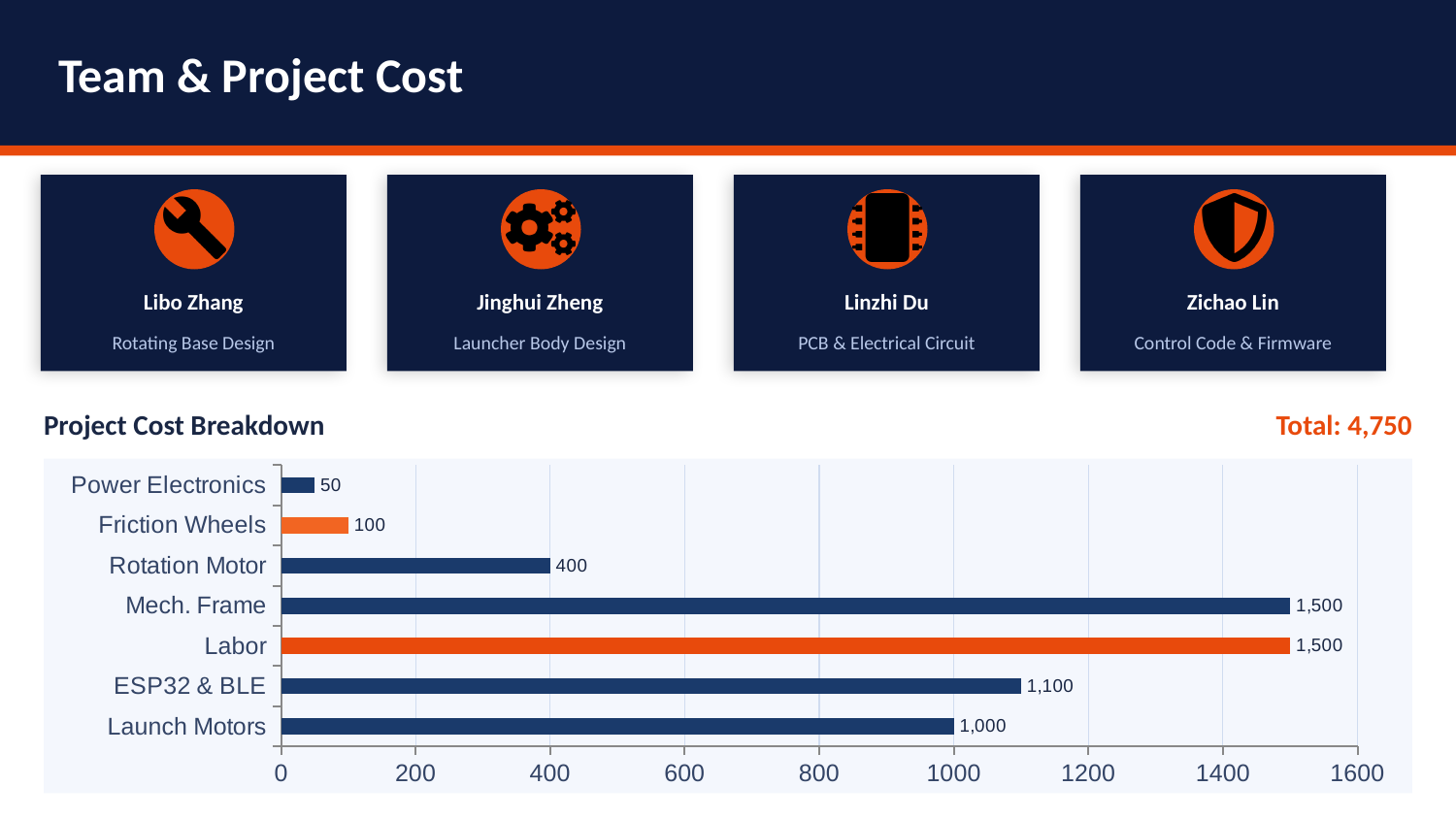
What kind of chart is the Project Cost Breakdown chart? Bar chart What is the value for Rotation Motor in the Project Cost Breakdown chart? 400 How many categories are shown in the Project Cost Breakdown chart? 7 What is the value for ESP32 & BLE in the Project Cost Breakdown chart? 1,100 What is the difference between the values for Mech. Frame and Rotation Motor in the Project Cost Breakdown chart? 1,100 What total is shown next to the Project Cost Breakdown chart title? Total: 4,750 Which is larger in the Project Cost Breakdown chart, the value for Labor or the value for Launch Motors? Labor What is the value for Friction Wheels in the Project Cost Breakdown chart? 100 Which category has the lowest value in the Project Cost Breakdown chart? Power Electronics What is the value for Launch Motors in the Project Cost Breakdown chart? 1,000 What is the difference between the values for ESP32 & BLE and Launch Motors in the Project Cost Breakdown chart? 100 Is the value for ESP32 & BLE in the Project Cost Breakdown chart greater or less than 1000? greater